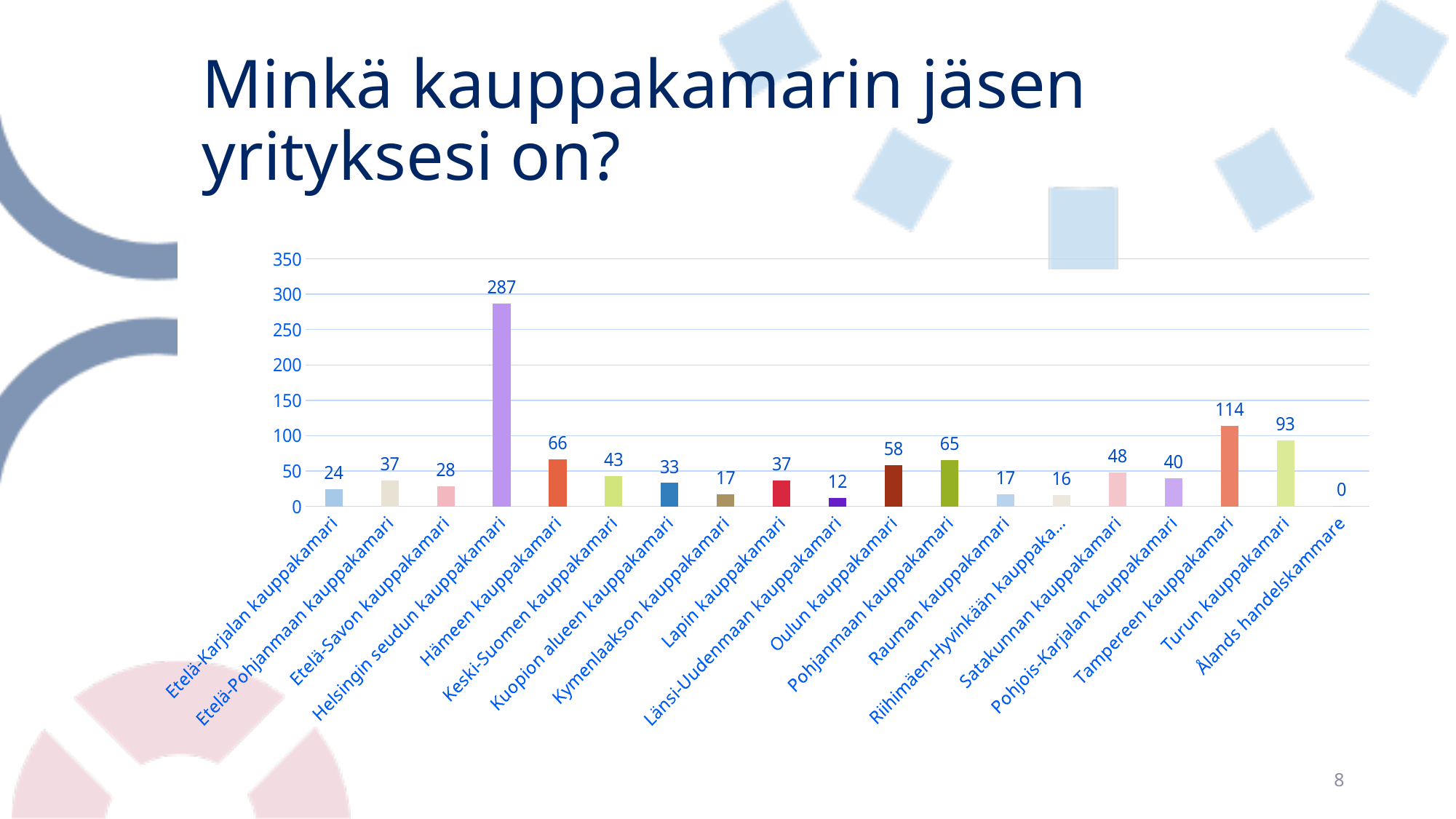
What kind of chart is shown on the slide? bar chart Which category has the lowest value? Ålands handelskammare What is the value for Tampereen kauppakamari? 114 Is the value for Helsingin seudun kauppakamari greater or less than 250? greater Which is larger, the value for Hämeen kauppakamari or the value for Pohjanmaan kauppakamari? Hämeen kauppakamari What is the value for Länsi-Uudenmaan kauppakamari? 12 What is the difference between the values for Tampereen kauppakamari and Turun kauppakamari? 21 How many categories are shown on the x axis? 19 What is the title of the slide? Minkä kauppakamarin jäsen yrityksesi on? What is the value for Helsingin seudun kauppakamari? 287 Which category has the highest value? Helsingin seudun kauppakamari What is the value for Oulun kauppakamari? 58